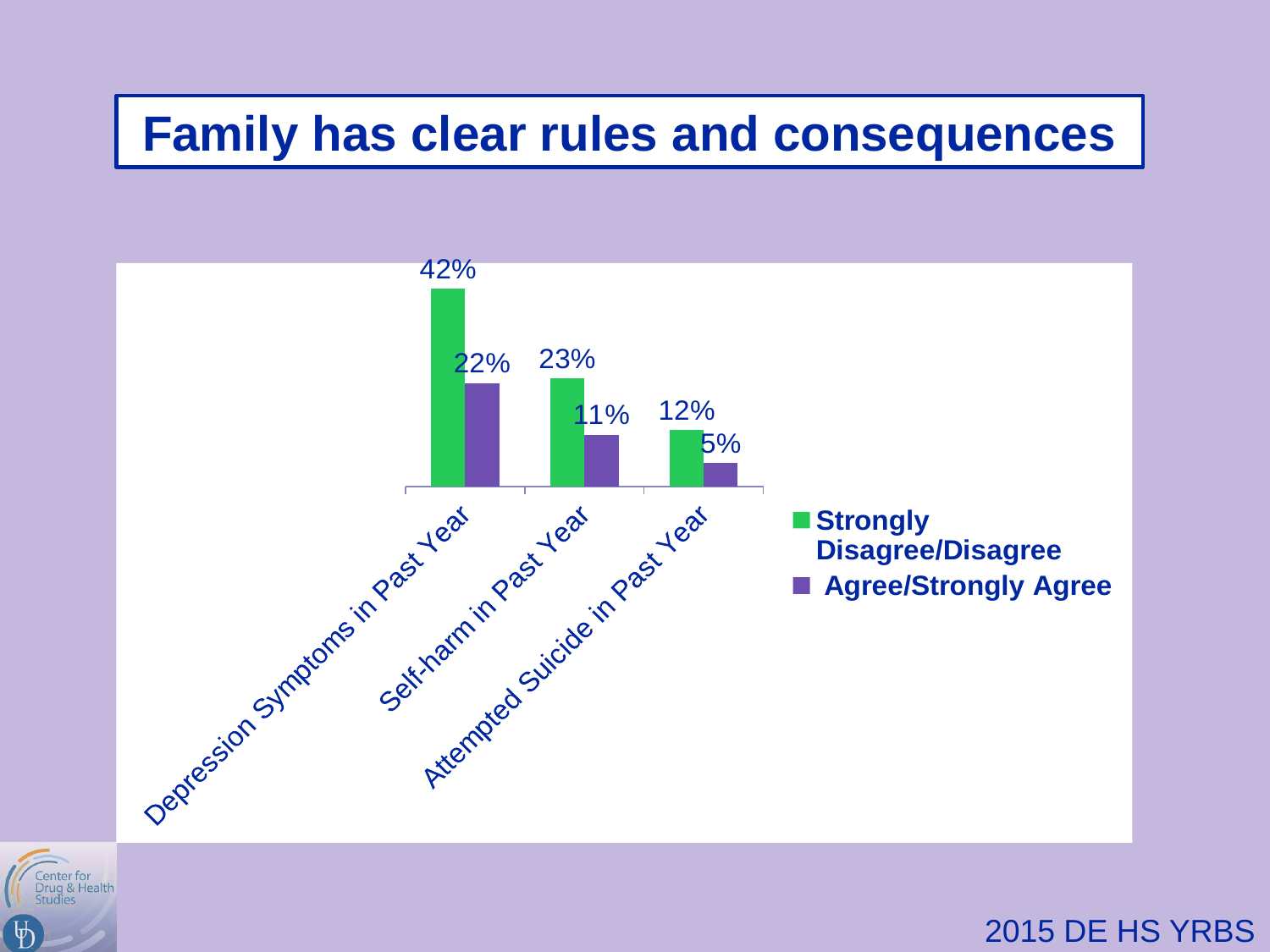
Which is larger for Self-harm in Past Year: Strongly Disagree/Disagree or Agree/Strongly Agree? Strongly Disagree/Disagree How many categories are shown on the x axis? 3 What is the difference between the Strongly Disagree/Disagree and Agree/Strongly Agree values for Attempted Suicide in Past Year? 7% What is the value for Strongly Disagree/Disagree for Depression Symptoms in Past Year? 42% What is the value for Agree/Strongly Agree for Self-harm in Past Year? 11% What is the value for Agree/Strongly Agree for Attempted Suicide in Past Year? 5% Which category has the highest Strongly Disagree/Disagree value? Depression Symptoms in Past Year What is the value for Strongly Disagree/Disagree for Self-harm in Past Year? 23% Which category has the lowest Agree/Strongly Agree value? Attempted Suicide in Past Year What is the difference between the Strongly Disagree/Disagree and Agree/Strongly Agree values for Depression Symptoms in Past Year? 20% What kind of chart is shown on the slide? Bar chart How many series does the legend list? 2